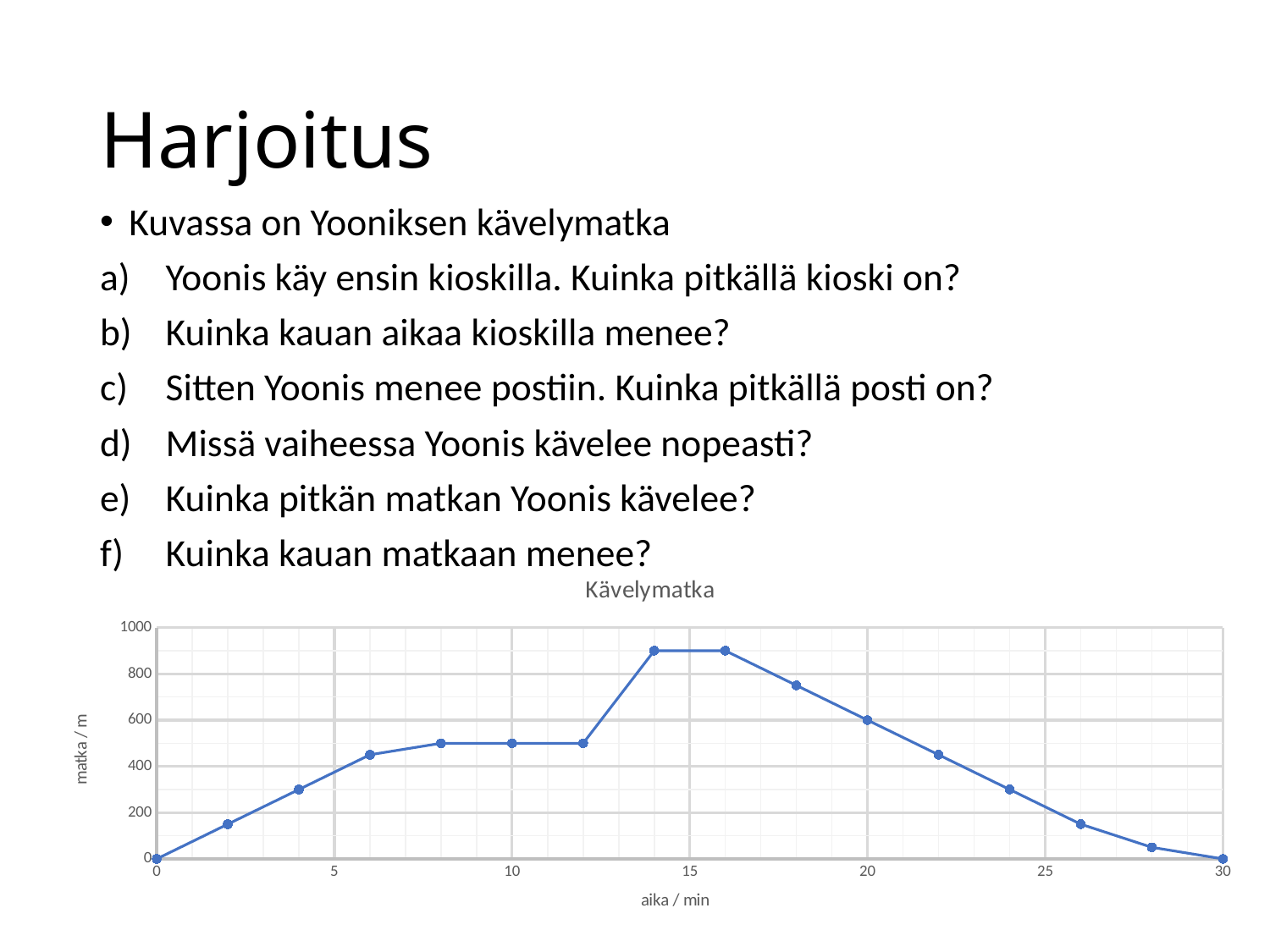
Which is larger, the value at 8 min or the value at 18 min? 18 min Is the value at 10 min greater or less than 400? greater How many data points are plotted on the line? 16 Is the value at 14 min greater or less than 800? greater What is the title of the chart? Kävelymatka What is the value of matka / m at 20 min? 600 What kind of chart is shown on the slide? line chart What is the value of matka / m at 30 min? 0 Is the value at 26 min greater or less than 200? less What is the label of the x axis of the chart? aika / min Do the values rise or fall along the x axis between 16 min and 30 min? fall